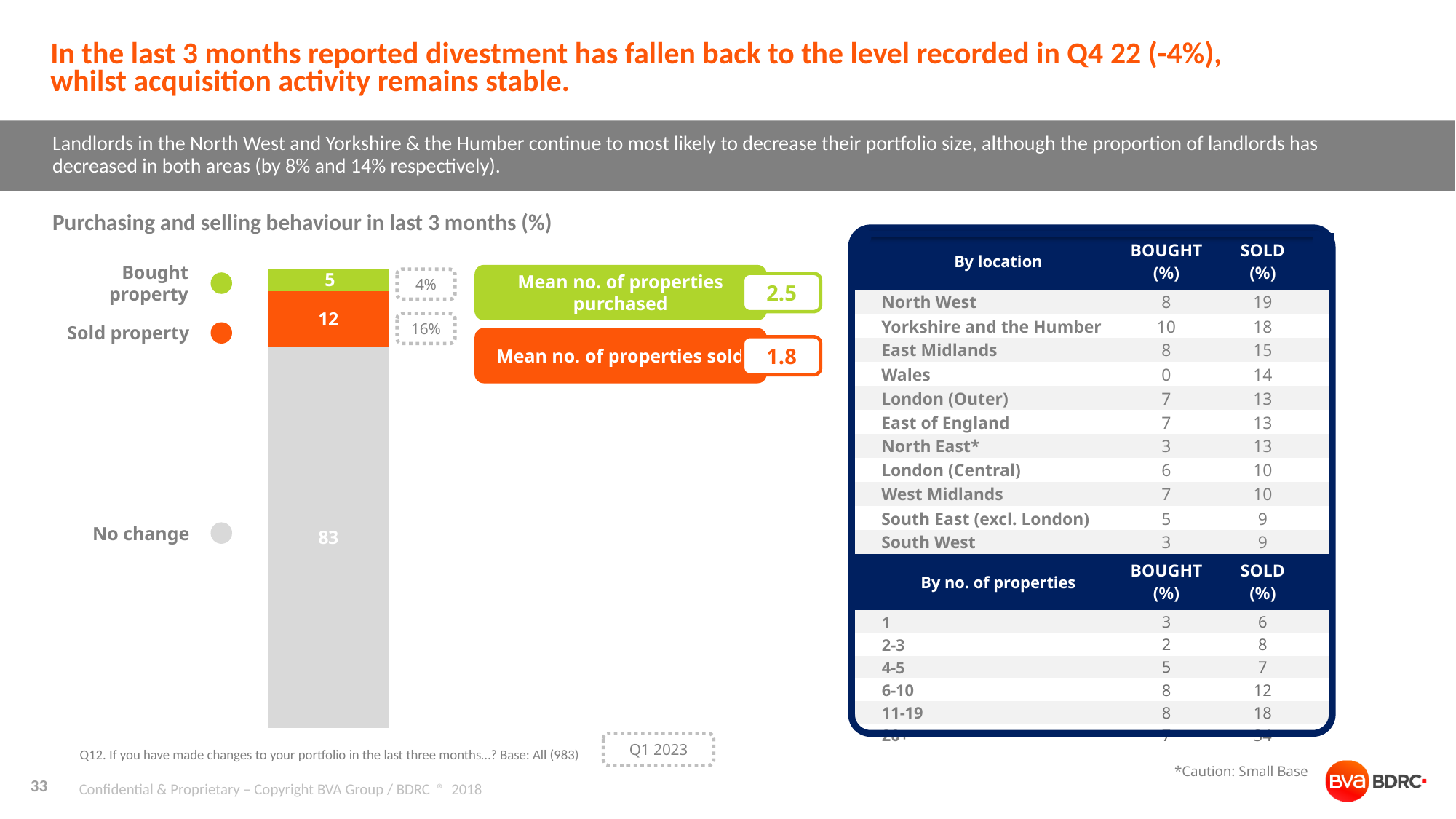
What is the value for Sold property in the stacked bar chart? 12 Which category has the largest segment in the stacked bar? No change What is the total of the three segments in the stacked bar? 100 What is the value for No change in the stacked bar chart? 83 What colour is the Sold property segment in the chart? Orange How many categories are shown in the stacked bar chart? 3 What is the title of the chart? Purchasing and selling behaviour in last 3 months (%) What is the value for Bought property in the stacked bar chart? 5 What is the difference between the Sold property and Bought property values? 7 What type of chart is used to show purchasing and selling behaviour? Stacked bar chart Which category has the smallest segment in the stacked bar? Bought property Which is larger, the Sold property value or the Bought property value? Sold property